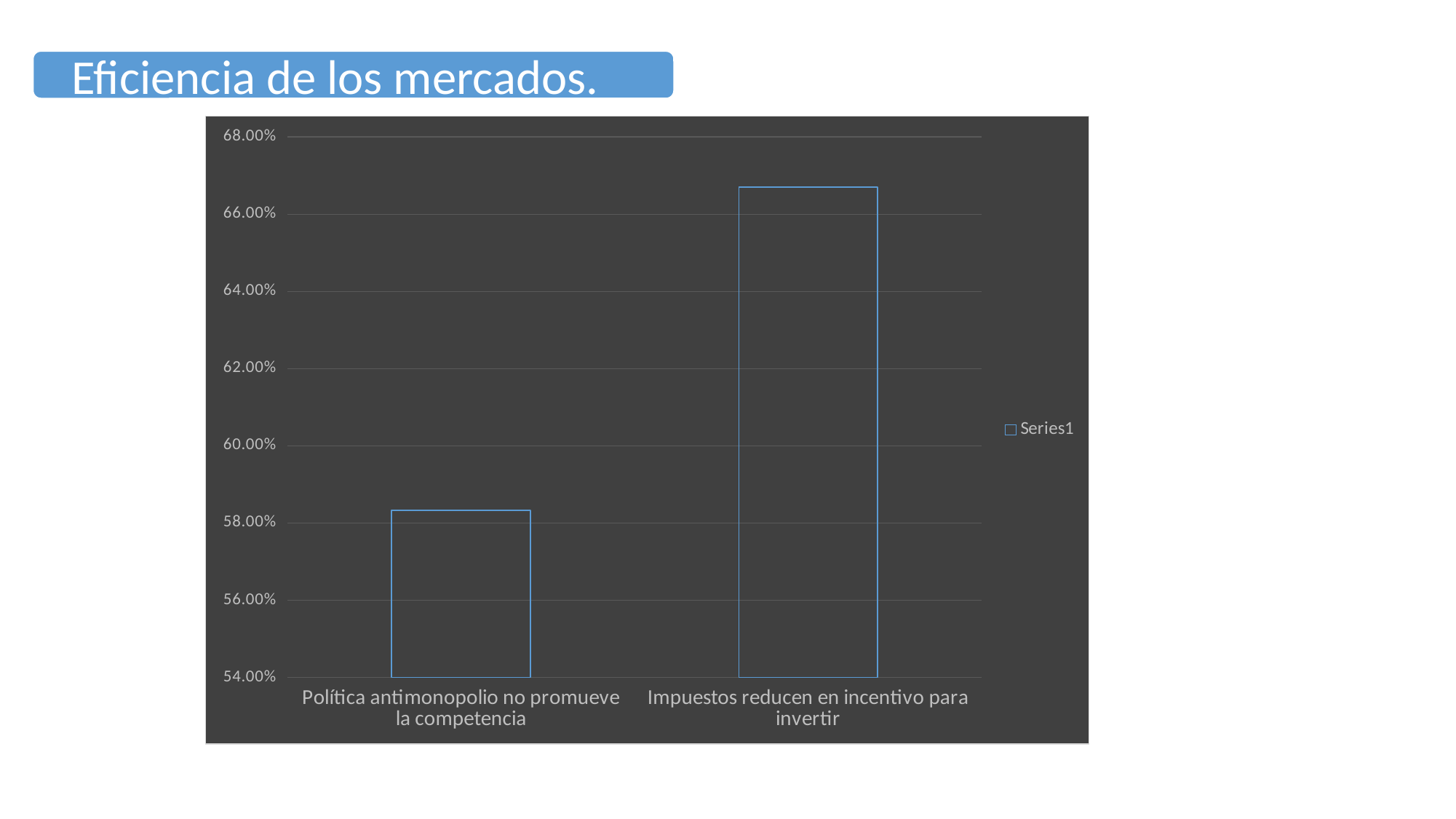
Is the value for 'Impuestos reducen en incentivo para invertir' greater or less than 68.00%? less Is the value for 'Política antimonopolio no promueve la competencia' greater or less than 60.00%? less What kind of chart is shown on the slide? bar chart What is the name of the series shown in the chart legend? Series1 Which is larger: the value for 'Política antimonopolio no promueve la competencia' or the value for 'Impuestos reducen en incentivo para invertir'? Impuestos reducen en incentivo para invertir Which category has the lowest value? Política antimonopolio no promueve la competencia What is the title shown above the chart on the slide? Eficiencia de los mercados. Is the value for 'Política antimonopolio no promueve la competencia' greater or less than 56.00%? greater How many categories are plotted on the chart? 2 How many series does the chart legend list? 1 Which category has the highest value? Impuestos reducen en incentivo para invertir